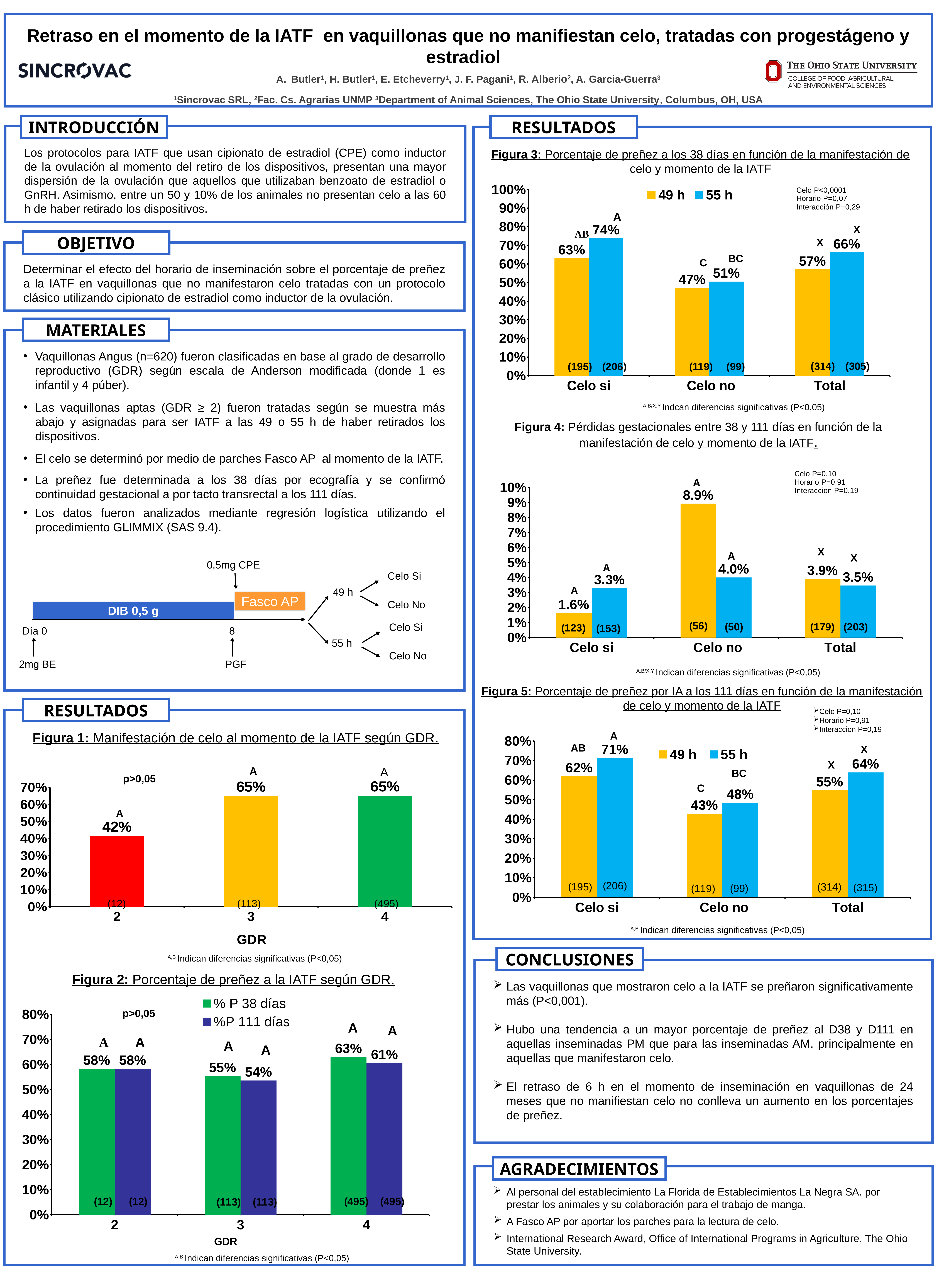
In Figura 3, what is the 55 h value for Celo si? 74% In Figura 2, what is the difference between the % P 38 días and %P 111 días values for GDR 4? 2% In Figura 3, which is larger for Celo no: the 49 h value or the 55 h value? 55 h In Figura 1, what is the value for GDR 2? 42% In Figura 4, which category has the highest 49 h value? Celo no In Figura 1, which GDR category has the lowest value? 2 In Figura 2, what is the % P 38 días value for GDR 4? 63% What kind of chart is Figura 5? bar chart In Figura 2, how many series does the legend list? 2 In Figura 4, what is the 55 h value for Celo si? 3.3% In Figura 3, what is the difference between the 55 h and 49 h values for Total? 9% In Figura 5, what is the 49 h value for Celo no? 43%